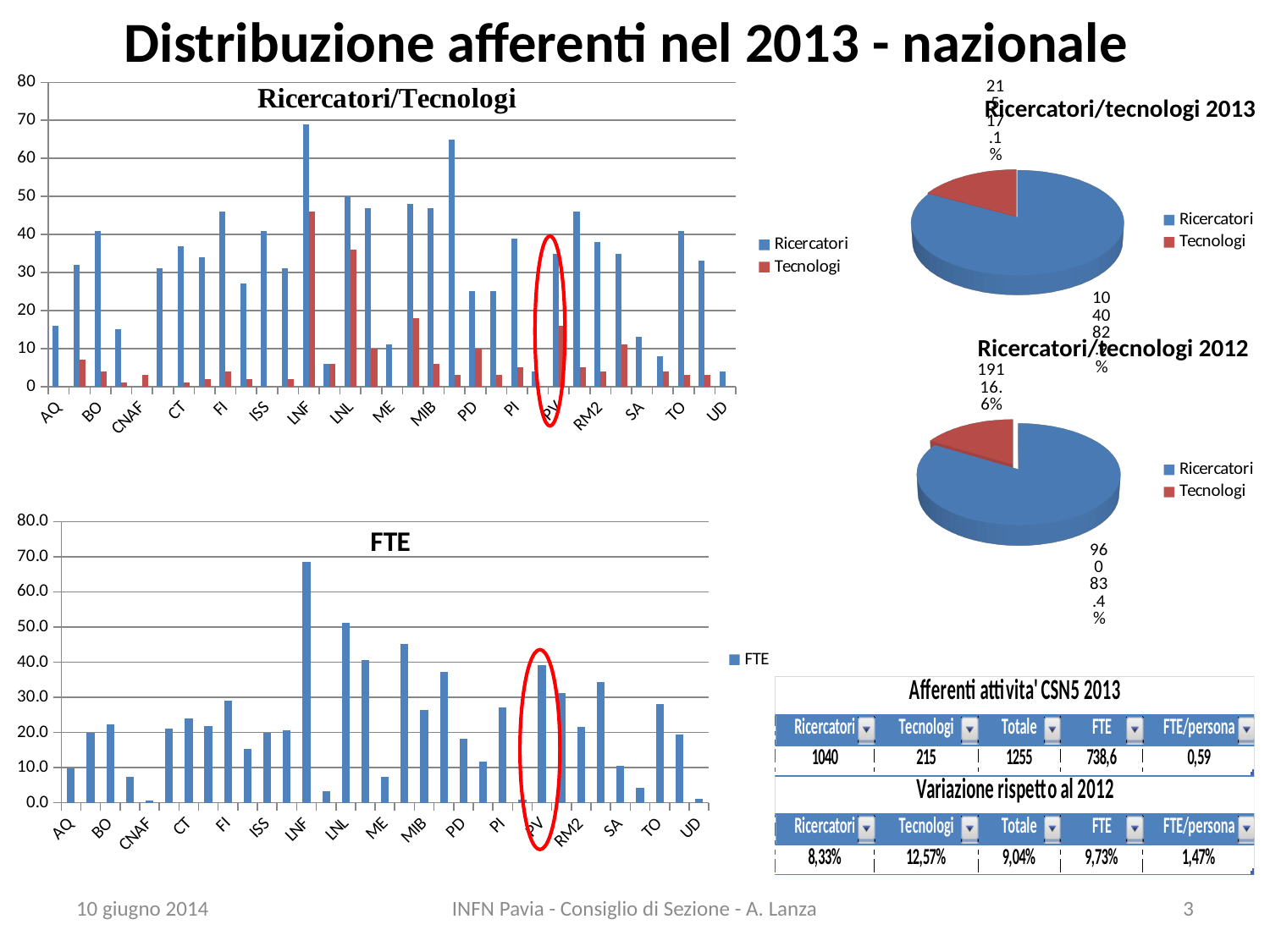
In the 'FTE' bar chart, which is larger, the FTE for LNF or the FTE for LNL? LNF How many series does the legend of the 'Ricercatori/Tecnologi' bar chart list? 2 What kind of chart is the 'Ricercatori/Tecnologi' chart on the left? bar chart In the 'FTE' bar chart, is the value for PV greater or less than 30? greater In the 'FTE' bar chart, which category has the highest FTE value? LNF What kind of chart is 'Ricercatori/tecnologi 2013'? pie chart In the 'Ricercatori/tecnologi 2012' pie chart, what is the value for Ricercatori? 960 In the 'Ricercatori/Tecnologi' bar chart, is the Tecnologi value for LNF greater or less than 40? greater In the 'Ricercatori/Tecnologi' bar chart, is the Ricercatori value for AQ greater or less than 20? less How many series does the legend of the 'FTE' chart list? 1 In the 'Ricercatori/tecnologi 2012' pie chart, what share of the pie is Tecnologi? 16.6%